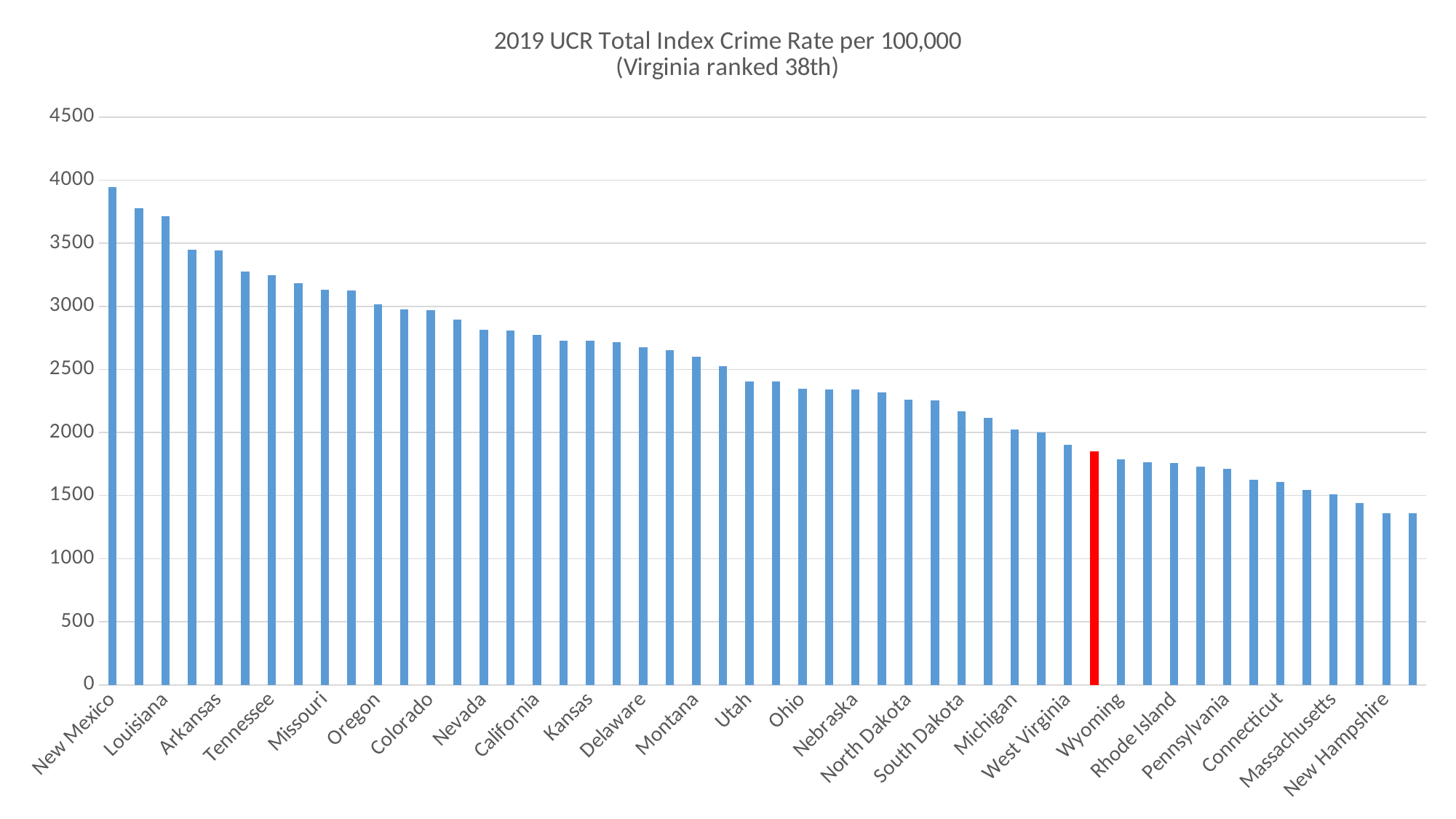
What kind of chart is shown on the slide? bar chart Is the value for Utah greater or less than 2500? less Is the value for the red bar (Virginia) greater or less than 2000? less Is the value for Tennessee greater or less than 3000? greater Which state has the highest crime rate in the chart? New Mexico What is the title of the chart? 2019 UCR Total Index Crime Rate per 100,000 (Virginia ranked 38th) Which has a higher crime rate, New Mexico or Louisiana? New Mexico Do the values rise or fall moving from left to right along the x axis? fall Which state is highlighted with a red bar? Virginia